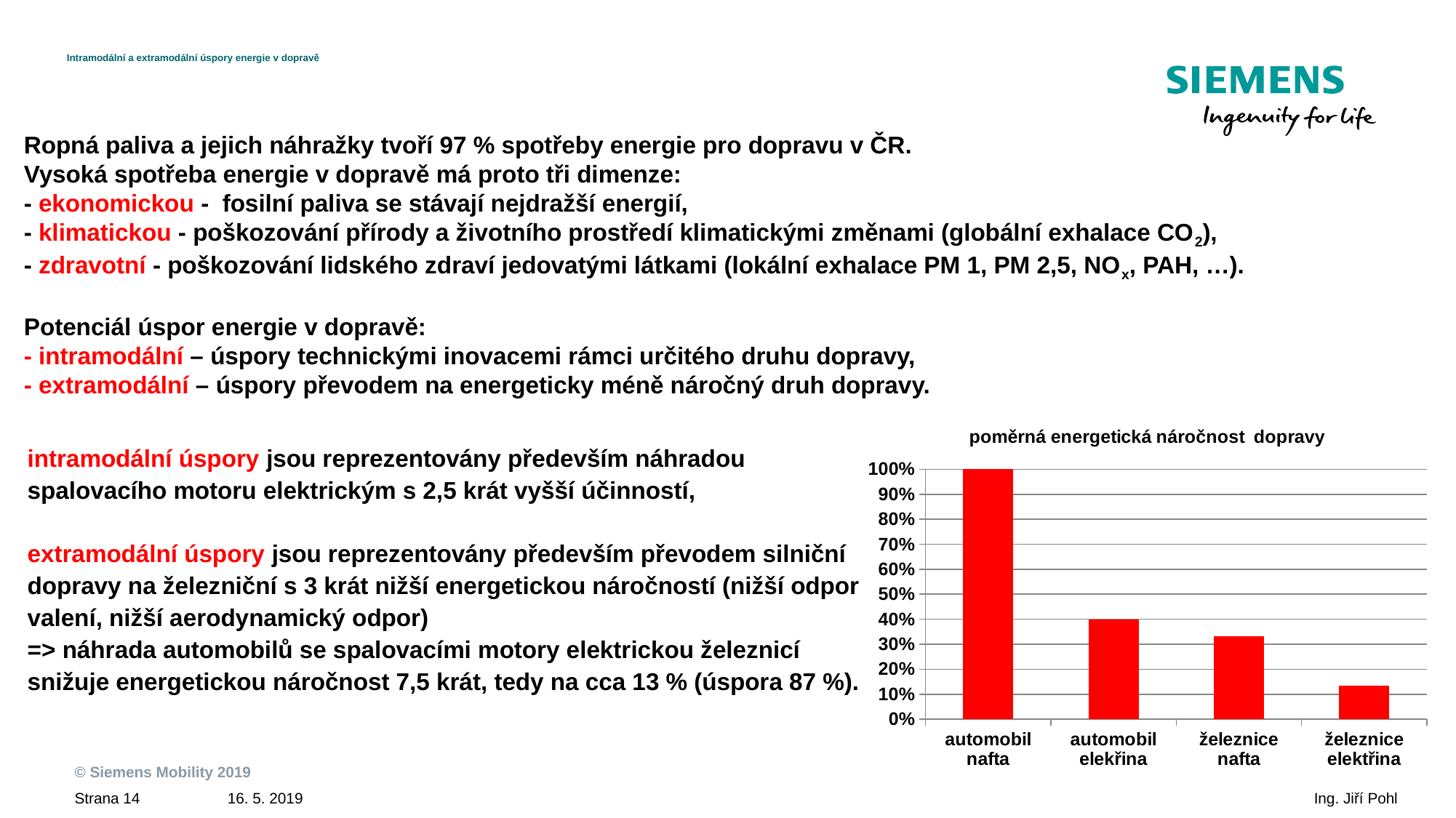
Do the values rise or fall from left to right along the x axis? fall What kind of chart is shown on the slide? bar chart What is the title of the chart? poměrná energetická náročnost dopravy What is the value for automobil nafta? 100% What is the value for automobil elektřina? 40% Is the value for železnice nafta greater or less than 30%? greater Which category has the highest value in the chart? automobil nafta How many categories are shown in the chart? 4 Which category has the lowest value in the chart? železnice elektřina Which is larger, the value for automobil elektřina or the value for železnice nafta? automobil elektřina Is the value for železnice nafta greater or less than 40%? less Is the value for železnice elektřina greater or less than 20%? less